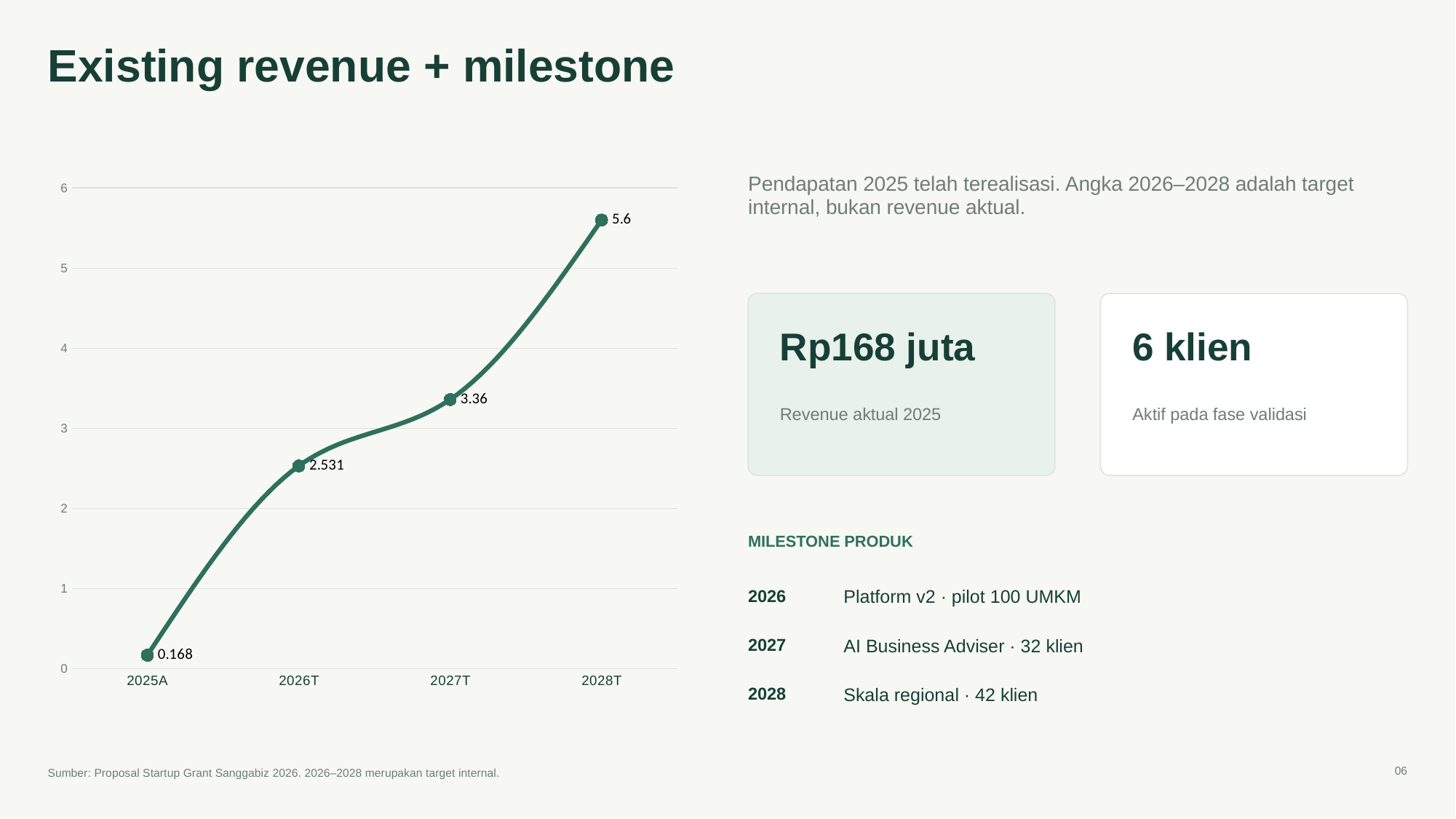
Which category has the lowest value? 2025A Do the values rise or fall from 2025A to 2028T? rise What is the value for 2026T? 2.531 Which category has the highest value? 2028T What is the value for 2025A? 0.168 What is the difference between the values for 2028T and 2027T? 2.24 How many data points are plotted on the chart? 4 What is the value for 2028T? 5.6 Which is larger, the value for 2026T or the value for 2027T? 2027T Is the value for 2026T greater or less than 2? greater What kind of chart is shown on the slide? line chart What is the value for 2027T? 3.36